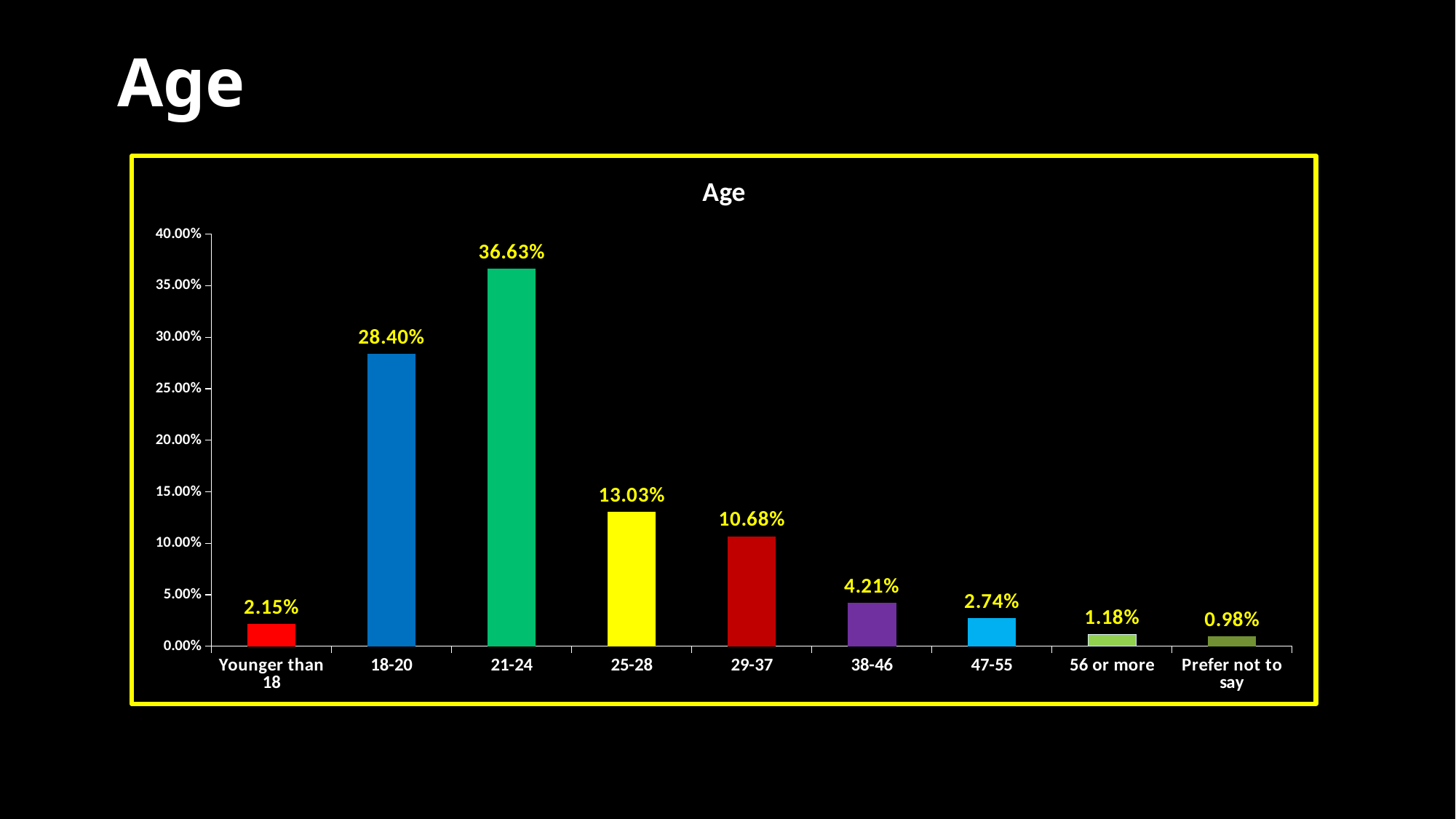
Which age category has the highest value? 21-24 Which category has the lowest value? Prefer not to say What kind of chart is shown on the slide? Bar chart What is the difference between the values for 21-24 and 18-20? 8.23% What is the value for the 21-24 age group? 36.63% What is the value for the 38-46 age group? 4.21% What is the value for the 'Prefer not to say' category? 0.98% Is the value for 25-28 greater or less than 15.00%? less What is the value for the 18-20 age group? 28.40% Which is larger, the value for 47-55 or the value for Younger than 18? 47-55 How many age categories are shown on the x axis? 9 What is the difference between the values for 25-28 and 29-37? 2.35%